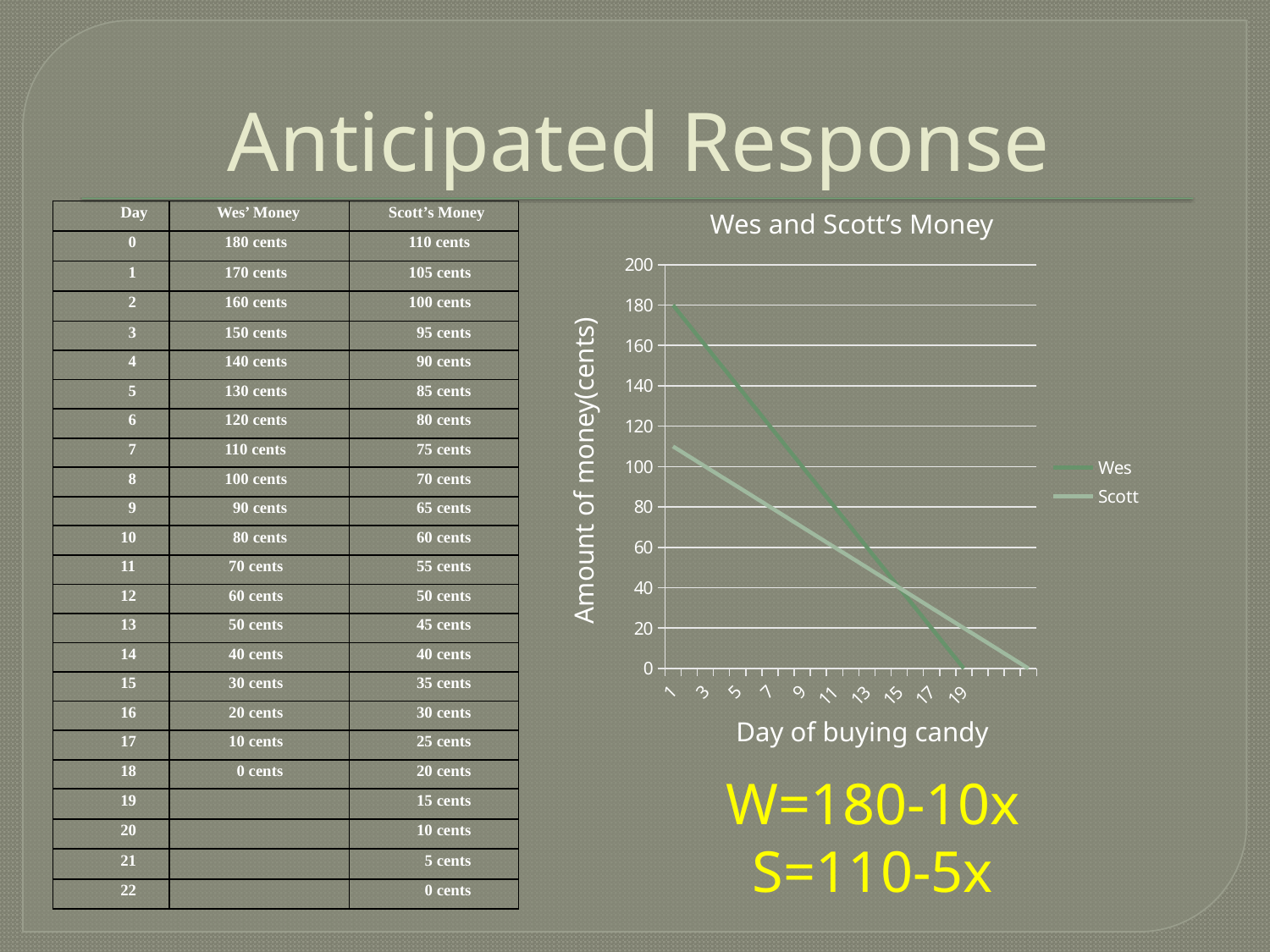
What kind of chart is shown on the slide? line chart What are the two series named in the chart legend? Wes and Scott Is the value of the Scott line at x = 11 greater or less than 80? less What is the title of the chart? Wes and Scott's Money At x = 3, which line is higher, Wes or Scott? Wes At x = 19, which line is higher, Wes or Scott? Scott Is the value of the Wes line at x = 15 greater or less than 100? less Does the Wes line rise or fall as the day of buying candy increases? fall How many series does the chart legend list? 2 Does the Scott line rise or fall along the x axis? fall Is the value of the Wes line at x = 5 greater or less than 100? greater At what value on the y axis does the Wes line start at x = 1? 180